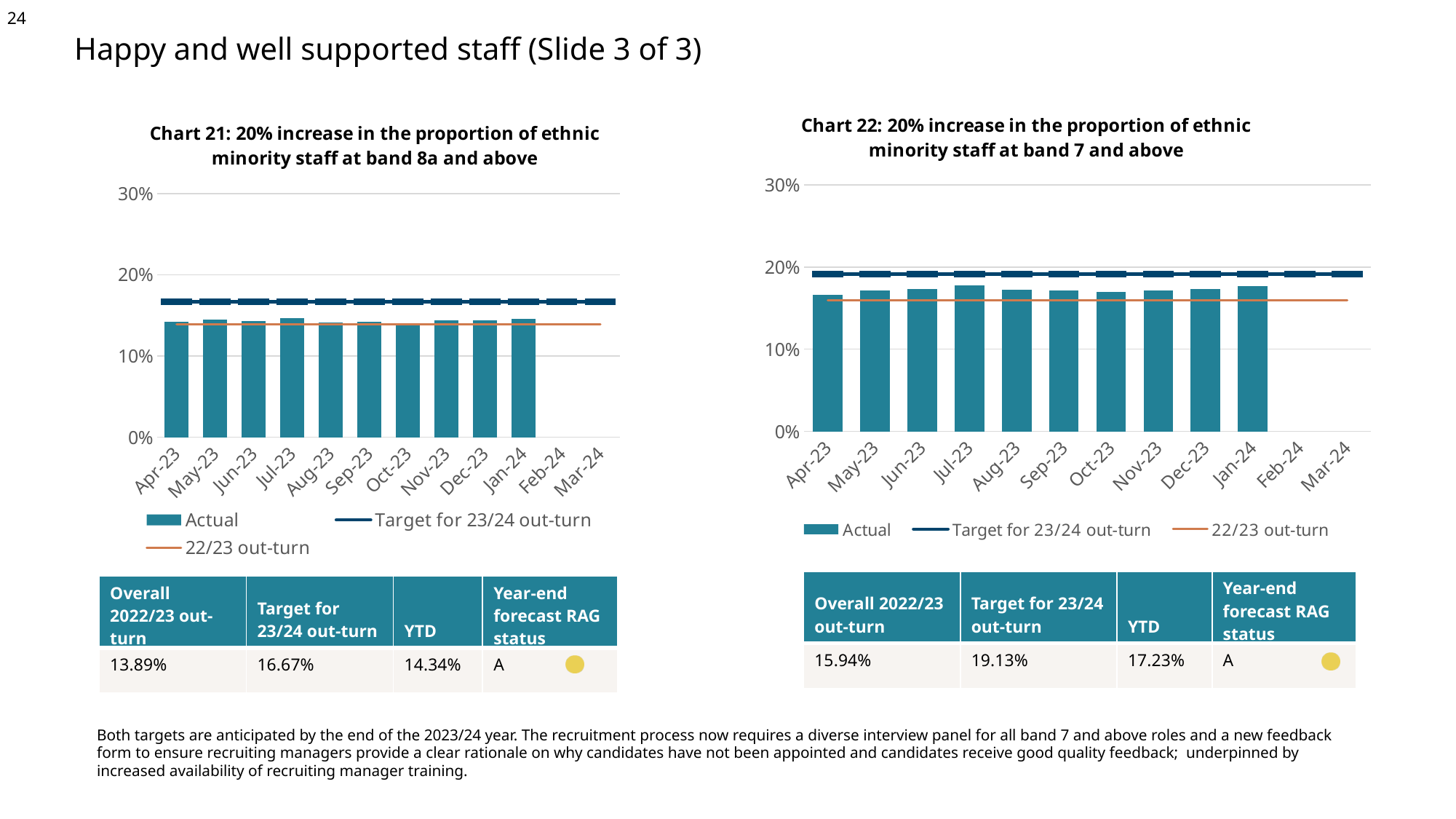
In Chart 21 (band 8a and above), how many series does the legend list? 3 In Chart 21 (band 8a and above), is the Actual value for Apr-23 greater or less than 10%? greater In Chart 22 (band 7 and above), what does the legend call the orange line series? 22/23 out-turn In Chart 22 (band 7 and above), which months on the x axis have no Actual bar plotted? Feb-24 and Mar-24 What kind of chart is Chart 21: 20% increase in the proportion of ethnic minority staff at band 8a and above? Bar chart In Chart 21 (band 8a and above), how many month categories are shown on the x axis? 12 In Chart 21 (band 8a and above), is the Actual value for Jul-23 greater or less than 20%? less In Chart 22 (band 7 and above), which has the larger Actual bar, Apr-23 or Jul-23? Jul-23 In Chart 22 (band 7 and above), how many series does the legend list? 3 In Chart 21 (band 8a and above), how many months have an Actual bar plotted? 10 In Chart 22 (band 7 and above), which month has the lowest Actual bar? Apr-23 In Chart 22 (band 7 and above), is the Actual value for Jan-24 greater or less than 20%? less